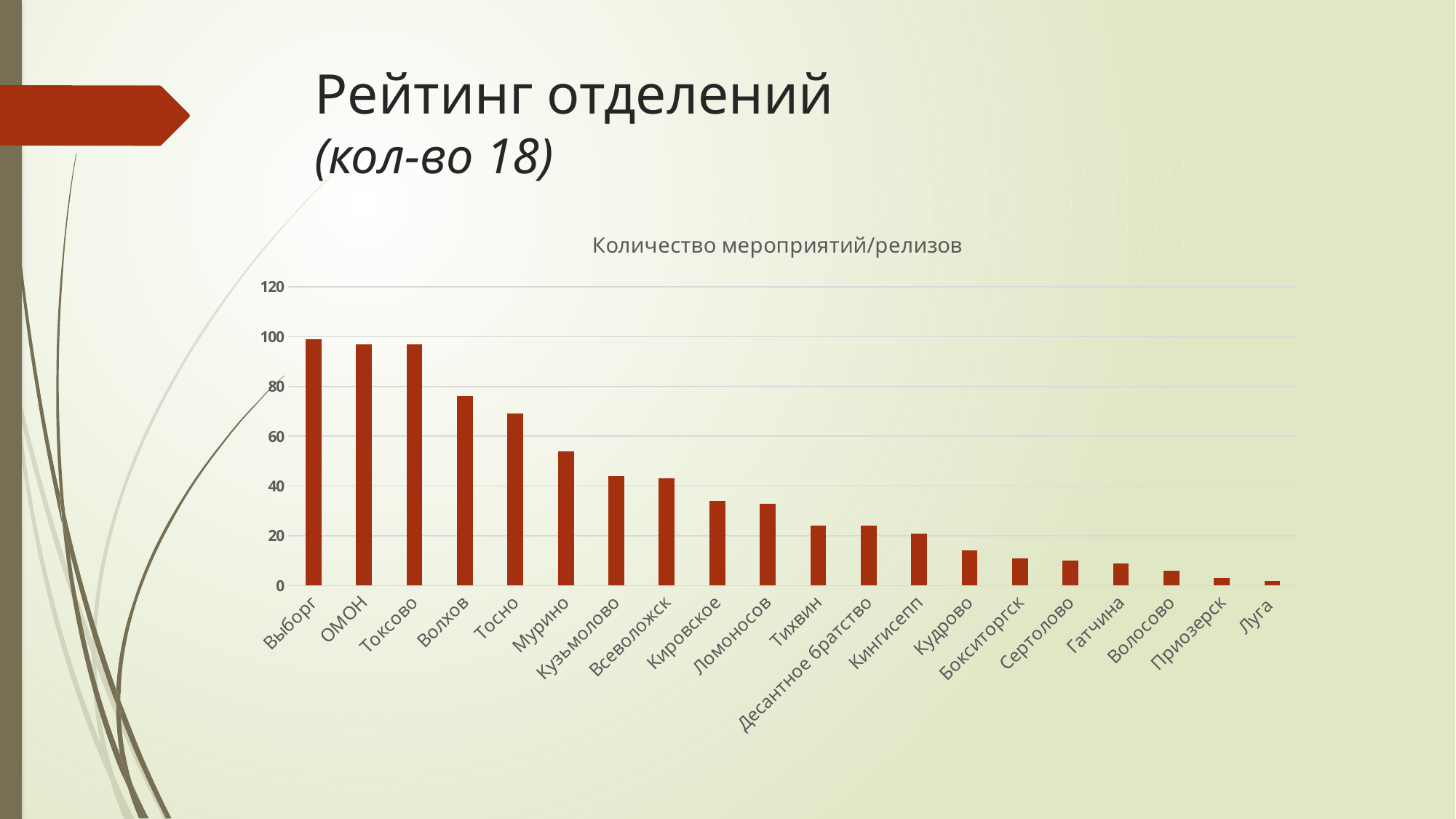
Is the value for Тосно greater or less than 80? less Is the value for Кировское greater or less than 40? less Which has the larger value, Волхов or Мурино? Волхов How many categories (отделения) are plotted on the chart? 20 Which has the larger value, Ломоносов or Кингисепп? Ломоносов What is the title of the chart? Количество мероприятий/релизов What kind of chart is shown on the slide? bar chart Is the value for Мурино greater or less than 40? greater Do the values rise or fall moving from left to right along the x axis? fall Which category has the lowest value on the chart? Луга